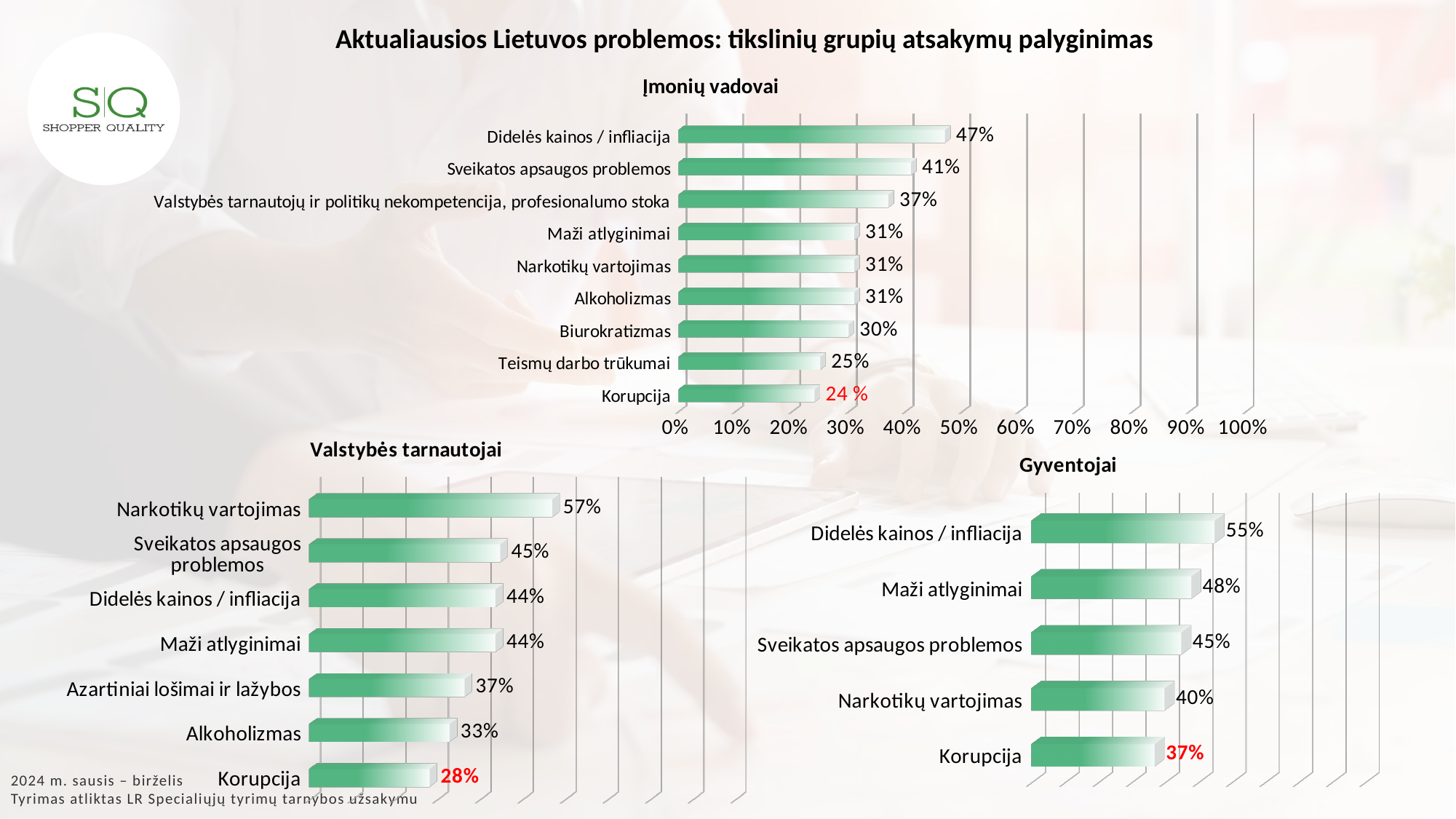
In the 'Įmonių vadovai' chart, what is the difference between Didelės kainos / infliacija and Sveikatos apsaugos problemos? 6% In the 'Gyventojai' chart, what is the value for Maži atlyginimai? 48% What kind of chart is the 'Gyventojai' chart? Bar chart In the 'Įmonių vadovai' chart, which category has the lowest value? Korupcija In the 'Įmonių vadovai' chart, what is the value for Didelės kainos / infliacija? 47% How many categories are shown in the 'Įmonių vadovai' chart? 9 In the 'Valstybės tarnautojai' chart, which category has the highest value? Narkotikų vartojimas In the 'Gyventojai' chart, which is larger: Sveikatos apsaugos problemos or Narkotikų vartojimas? Sveikatos apsaugos problemos In the 'Įmonių vadovai' chart, what is the value for Korupcija? 24 % In the 'Valstybės tarnautojai' chart, what is the difference between Narkotikų vartojimas and Korupcija? 29% How many categories are shown in the 'Gyventojai' chart? 5 In the 'Valstybės tarnautojai' chart, what is the value for Azartiniai lošimai ir lažybos? 37%